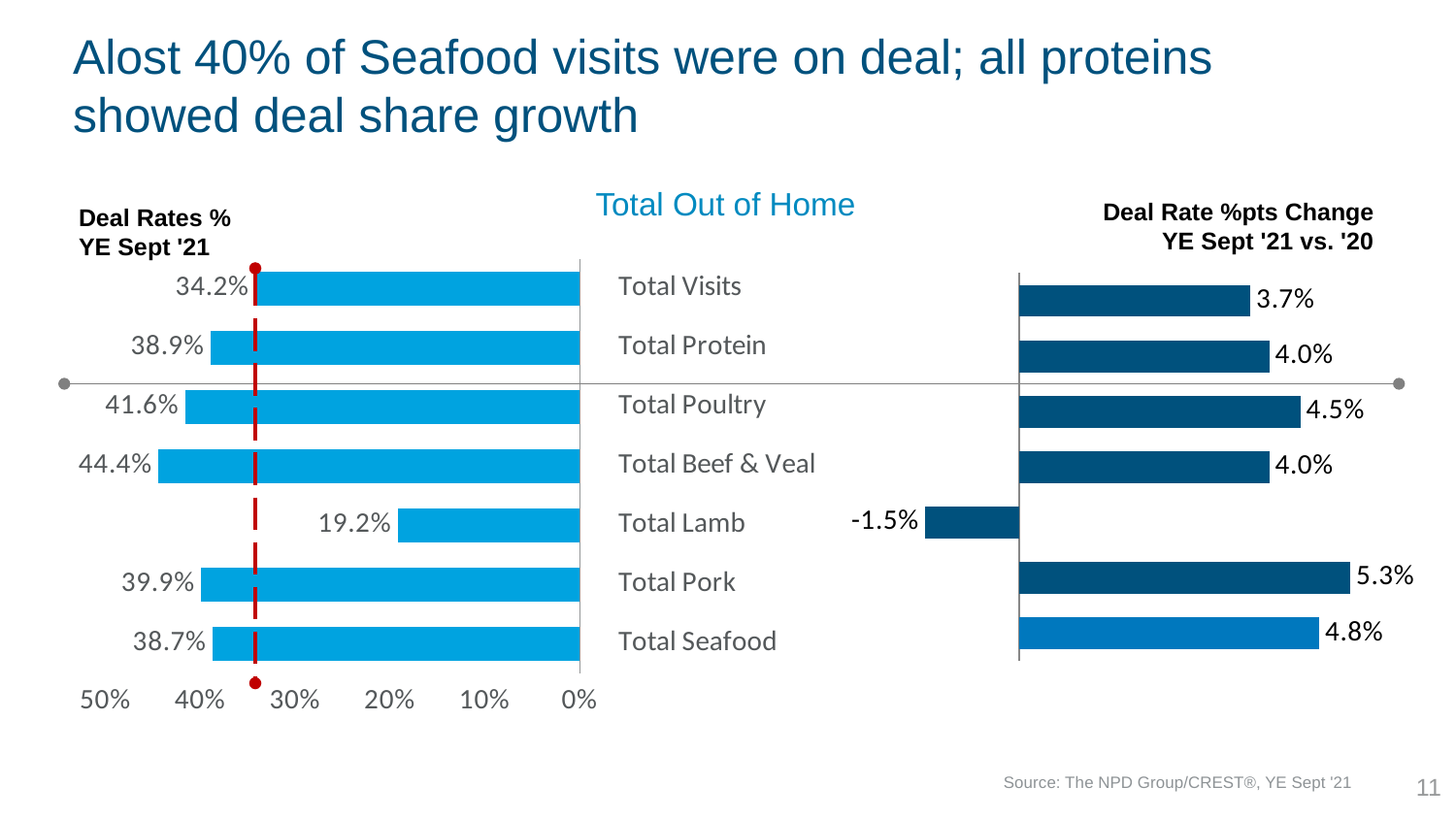
In the Deal Rates % YE Sept '21 chart, which category has the lowest deal rate? Total Lamb In the Deal Rates % YE Sept '21 chart, what is the difference between the deal rates for Total Beef & Veal and Total Visits? 10.2 percentage points In the Deal Rates % YE Sept '21 chart, what is the deal rate for Total Lamb? 19.2% In the Deal Rate %pts Change YE Sept '21 vs. '20 chart, which category has the largest change? Total Pork What type of chart is the Deal Rate %pts Change YE Sept '21 vs. '20 chart? Bar chart In the Deal Rates % YE Sept '21 chart, what is the deal rate for Total Seafood? 38.7% In the Deal Rate %pts Change YE Sept '21 vs. '20 chart, which is larger, the value for Total Seafood or Total Poultry? Total Seafood In the Deal Rates % YE Sept '21 chart, which category has the highest deal rate? Total Beef & Veal In the Deal Rates % YE Sept '21 chart, is the deal rate for Total Poultry greater or less than 40%? greater In the Deal Rate %pts Change YE Sept '21 vs. '20 chart, what is the value for Total Pork? 5.3% In the Deal Rate %pts Change YE Sept '21 vs. '20 chart, what is the value for Total Lamb? -1.5% How many categories are shown in the Deal Rates % YE Sept '21 chart? 7